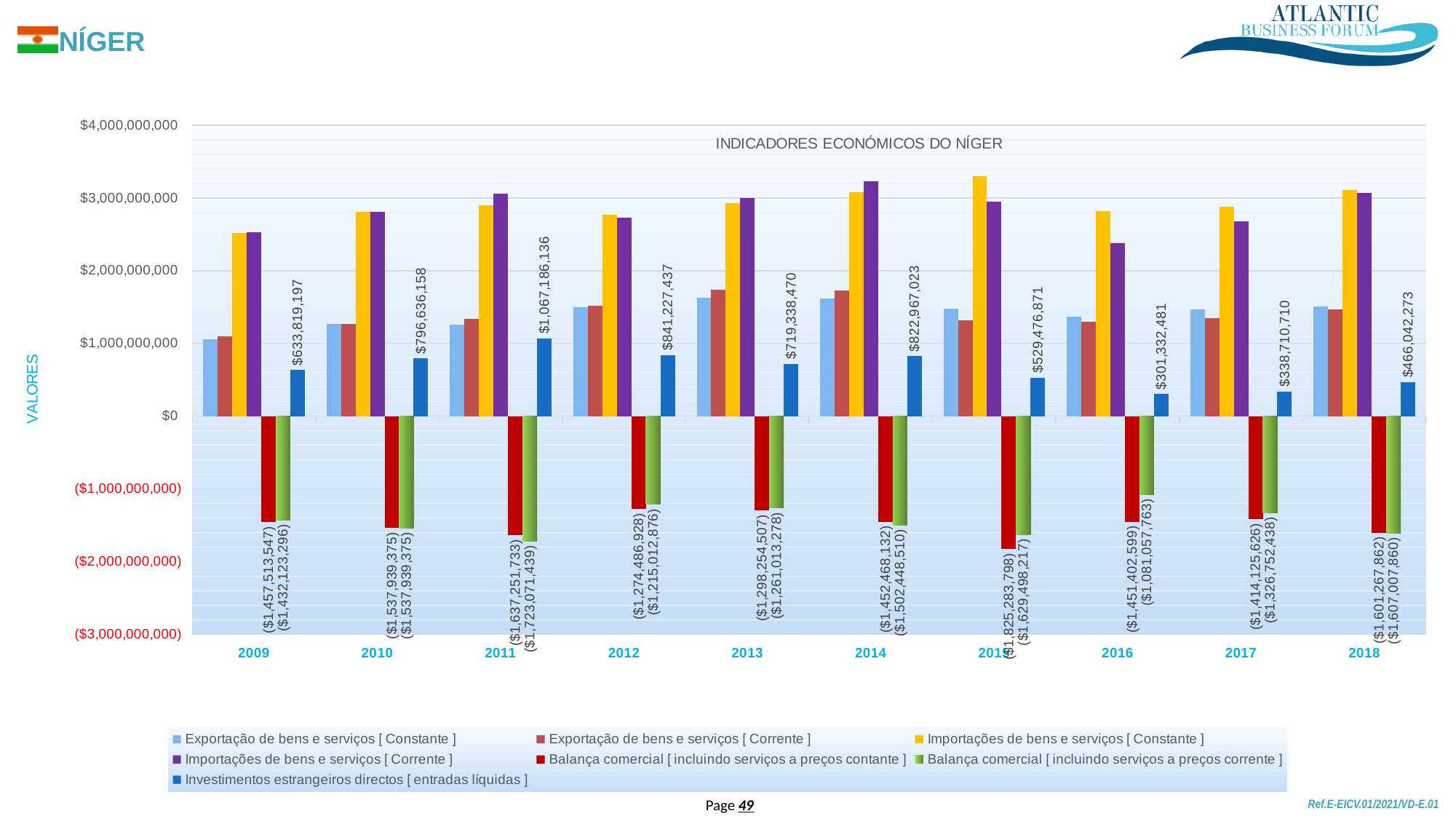
In which year is Investimentos estrangeiros directos [ entradas líquidas ] lowest? 2016 What is the title of the chart? INDICADORES ECONÓMICOS DO NÍGER How many series does the legend list? 7 What is the difference between Investimentos estrangeiros directos in 2011 and in 2016? $765,853,655 Is the value for Importações de bens e serviços [ Constante ] in 2015 greater or less than $3,000,000,000? greater What is the value of Balança comercial [ incluindo serviços a preços contante ] in 2015? ($1,825,283,798) In which year is Investimentos estrangeiros directos [ entradas líquidas ] highest? 2011 How many years are shown on the x axis of the chart? 10 What is the value of Balança comercial [ incluindo serviços a preços corrente ] in 2016? ($1,081,057,763) Which year has the larger value for Investimentos estrangeiros directos, 2009 or 2010? 2010 What is the value of Investimentos estrangeiros directos [ entradas líquidas ] in 2011? $1,067,186,136 What is the value of Investimentos estrangeiros directos [ entradas líquidas ] in 2016? $301,332,481